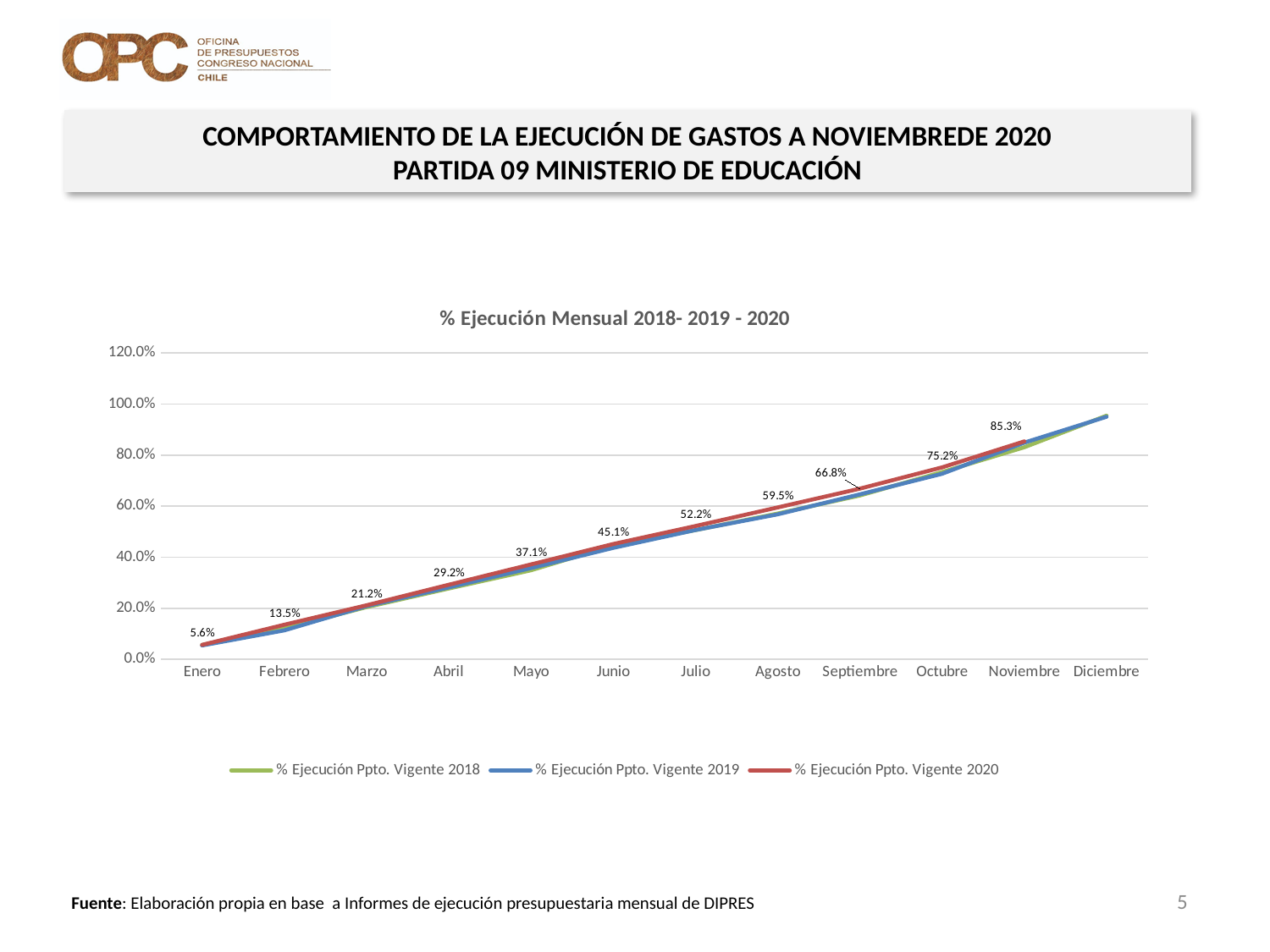
How many months are shown on the x axis? 12 What is the labelled value for % Ejecución Ppto. Vigente 2020 in Septiembre? 66.8% How many series does the legend list? 3 What type of chart is shown on the slide? line chart What is the labelled value for % Ejecución Ppto. Vigente 2020 in Junio? 45.1% Do the values of the % Ejecución Ppto. Vigente 2020 series rise or fall from Enero to Noviembre? rise What is the labelled value for % Ejecución Ppto. Vigente 2020 in Noviembre? 85.3% Is the value for % Ejecución Ppto. Vigente 2019 in Diciembre greater or less than 80.0%? greater Which month has the lowest labelled value for % Ejecución Ppto. Vigente 2020? Enero What is the labelled value for % Ejecución Ppto. Vigente 2020 in Enero? 5.6% What is the title of the chart? % Ejecución Mensual 2018- 2019 - 2020 What is the difference between the labelled 2020 values for Noviembre and Octubre? 10.1%